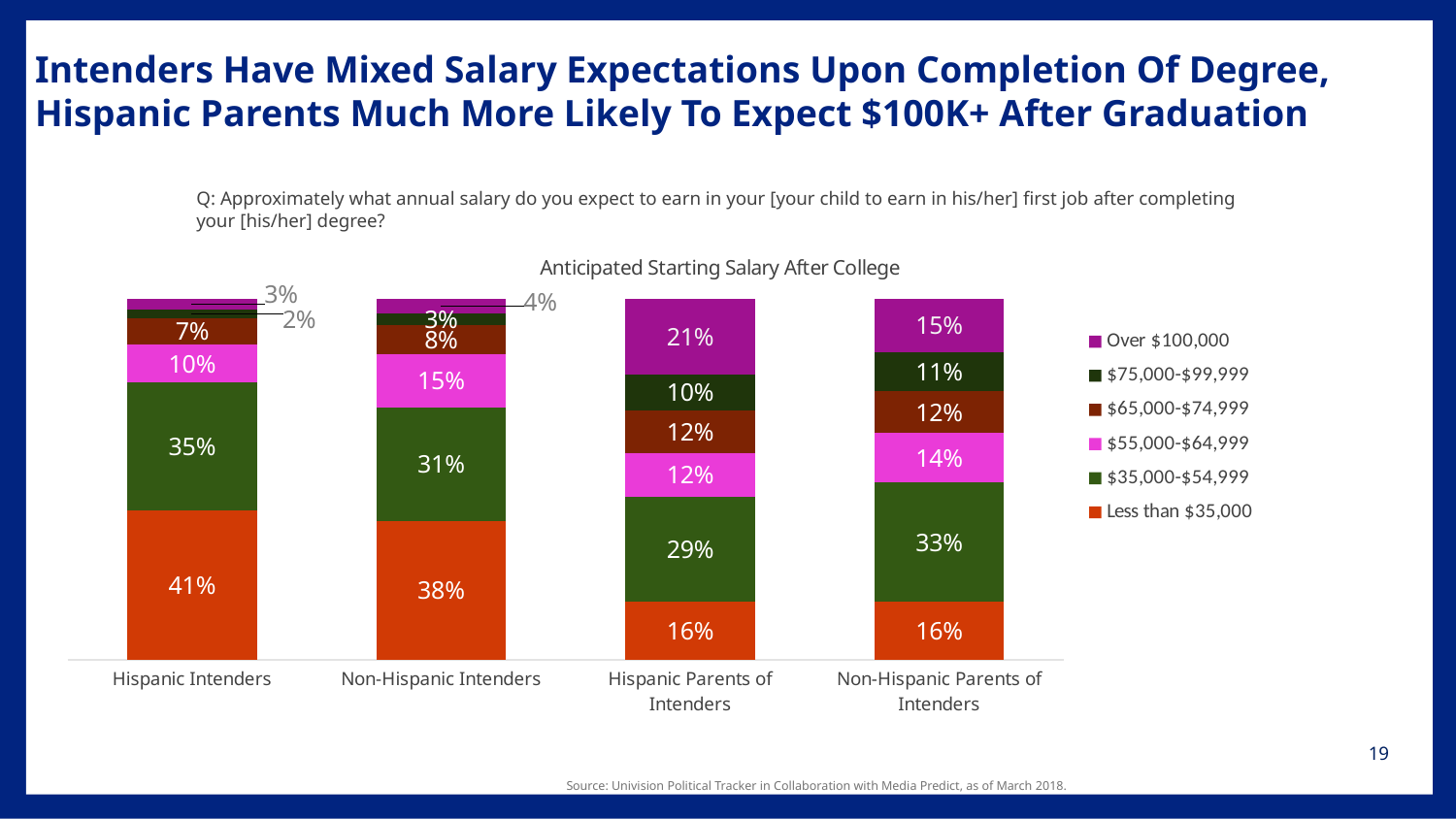
What kind of chart is shown on the slide? Stacked bar chart How many series does the legend list? 6 What is the value for $35,000-$54,999 among Non-Hispanic Parents of Intenders? 33% What is the title of the chart? Anticipated Starting Salary After College What is the value for $55,000-$64,999 among Non-Hispanic Intenders? 15% Which is larger: the $35,000-$54,999 share for Hispanic Intenders or for Non-Hispanic Intenders? Hispanic Intenders Which category has the lowest share expecting a salary of less than $35,000? Hispanic Parents of Intenders and Non-Hispanic Parents of Intenders (both 16%) Which category has the highest share expecting a salary over $100,000? Hispanic Parents of Intenders What percentage of Hispanic Parents of Intenders expect a salary over $100,000? 21% How many categories (bars) are shown on the x axis? 4 What percentage of Hispanic Intenders expect a starting salary of less than $35,000? 41% What is the difference between the Less than $35,000 share for Hispanic Intenders and for Non-Hispanic Intenders? 3 percentage points